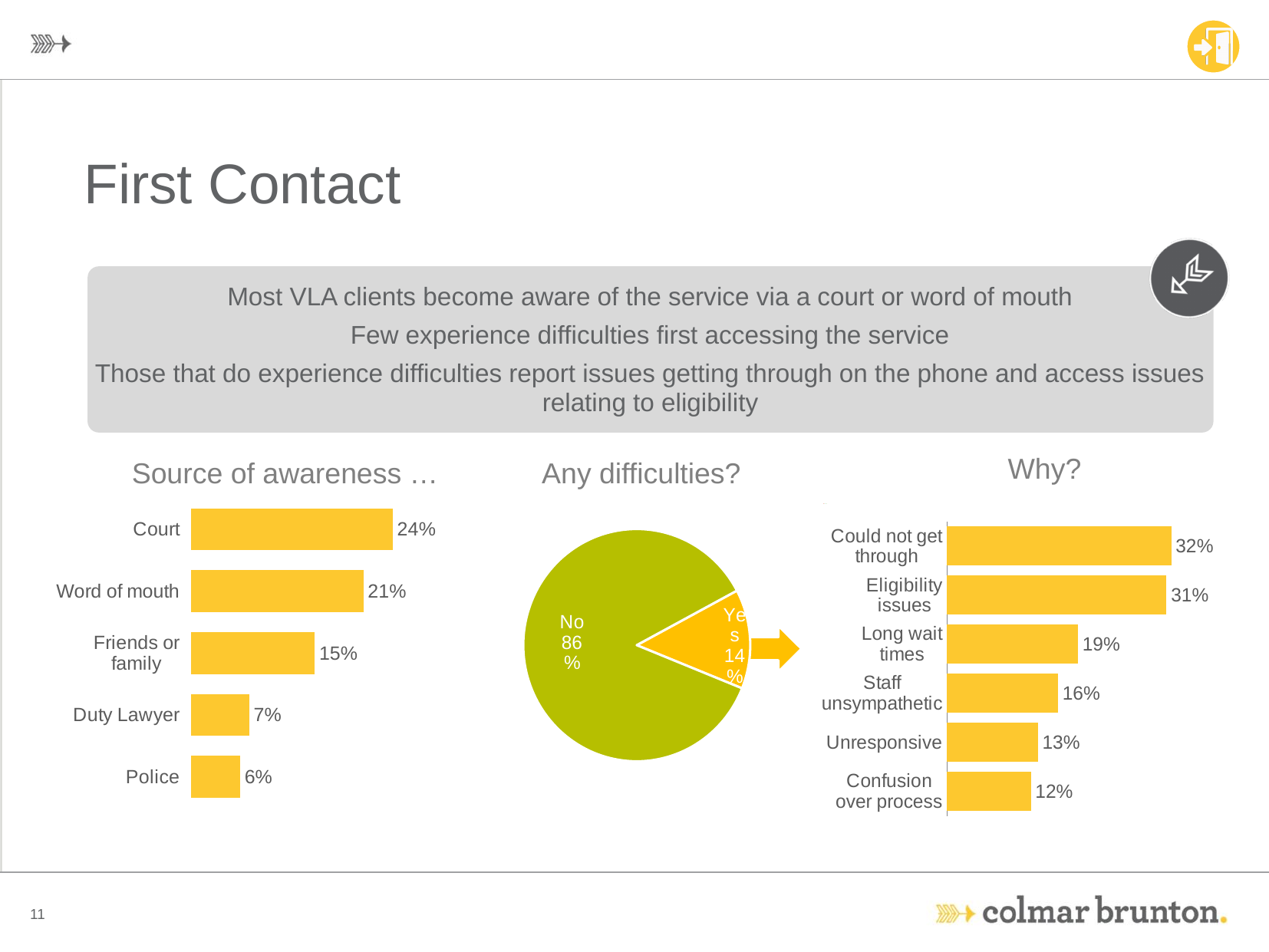
How many categories are shown in the 'Why?' chart? 6 What kind of chart is the 'Why?' chart? Bar chart In the 'Any difficulties?' pie chart, what is the value for 'Yes'? 14% In the 'Why?' chart, which is larger: Long wait times or Unresponsive? Long wait times In the 'Why?' chart, what is the value for Staff unsympathetic? 16% How many categories are shown in the 'Source of awareness …' chart? 5 In the 'Any difficulties?' pie chart, what share of the pie is 'No'? 86% In the 'Why?' chart, which category has the highest value? Could not get through In the 'Source of awareness …' chart, what is the value for Court? 24% In the 'Source of awareness …' chart, which category has the lowest value? Police In the 'Source of awareness …' chart, what is the difference between Word of mouth and Duty Lawyer? 14% What kind of chart is the 'Any difficulties?' chart? Pie chart